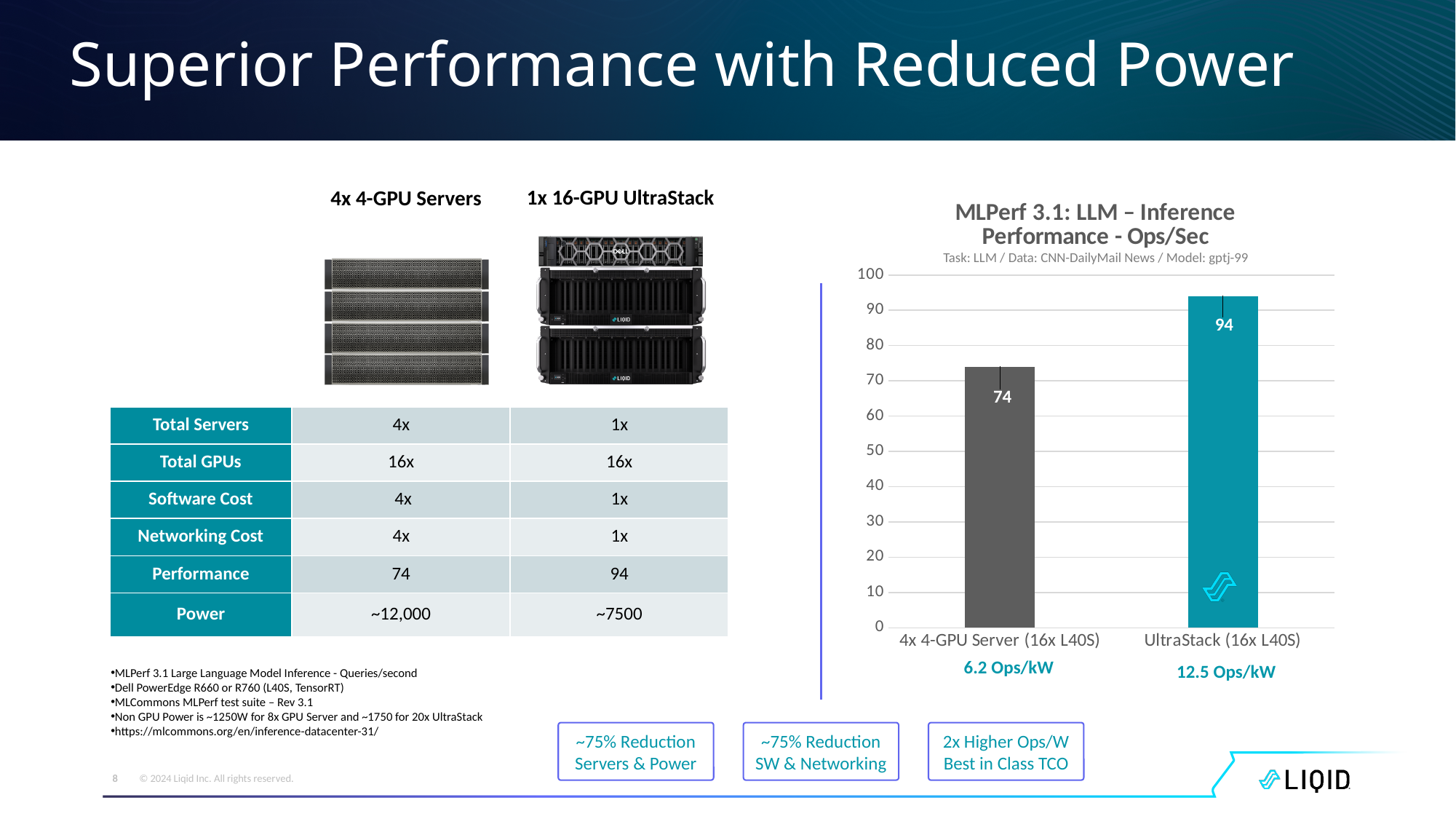
Is the value for UltraStack (16x L40S) in the MLPerf 3.1 chart greater or less than 90? greater Which is larger in the MLPerf 3.1 chart: the value for 4x 4-GPU Server (16x L40S) or for UltraStack (16x L40S)? UltraStack (16x L40S) Is the value for 4x 4-GPU Server (16x L40S) in the MLPerf 3.1 chart greater or less than 80? less What is the value for 4x 4-GPU Server (16x L40S) in the MLPerf 3.1 inference performance chart? 74 Which category has the highest value in the MLPerf 3.1 inference performance chart? UltraStack (16x L40S) What is the value for UltraStack (16x L40S) in the MLPerf 3.1 inference performance chart? 94 What Ops/kW figure is shown beneath the UltraStack (16x L40S) bar in the MLPerf 3.1 chart? 12.5 Ops/kW Which category has the lowest value in the MLPerf 3.1 inference performance chart? 4x 4-GPU Server (16x L40S) What is the maximum value shown on the y axis of the MLPerf 3.1 inference performance chart? 100 What is the difference between the UltraStack (16x L40S) and 4x 4-GPU Server (16x L40S) values in the MLPerf 3.1 chart? 20 How many categories are shown in the MLPerf 3.1 inference performance chart? 2 What kind of chart is the MLPerf 3.1 inference performance chart? bar chart